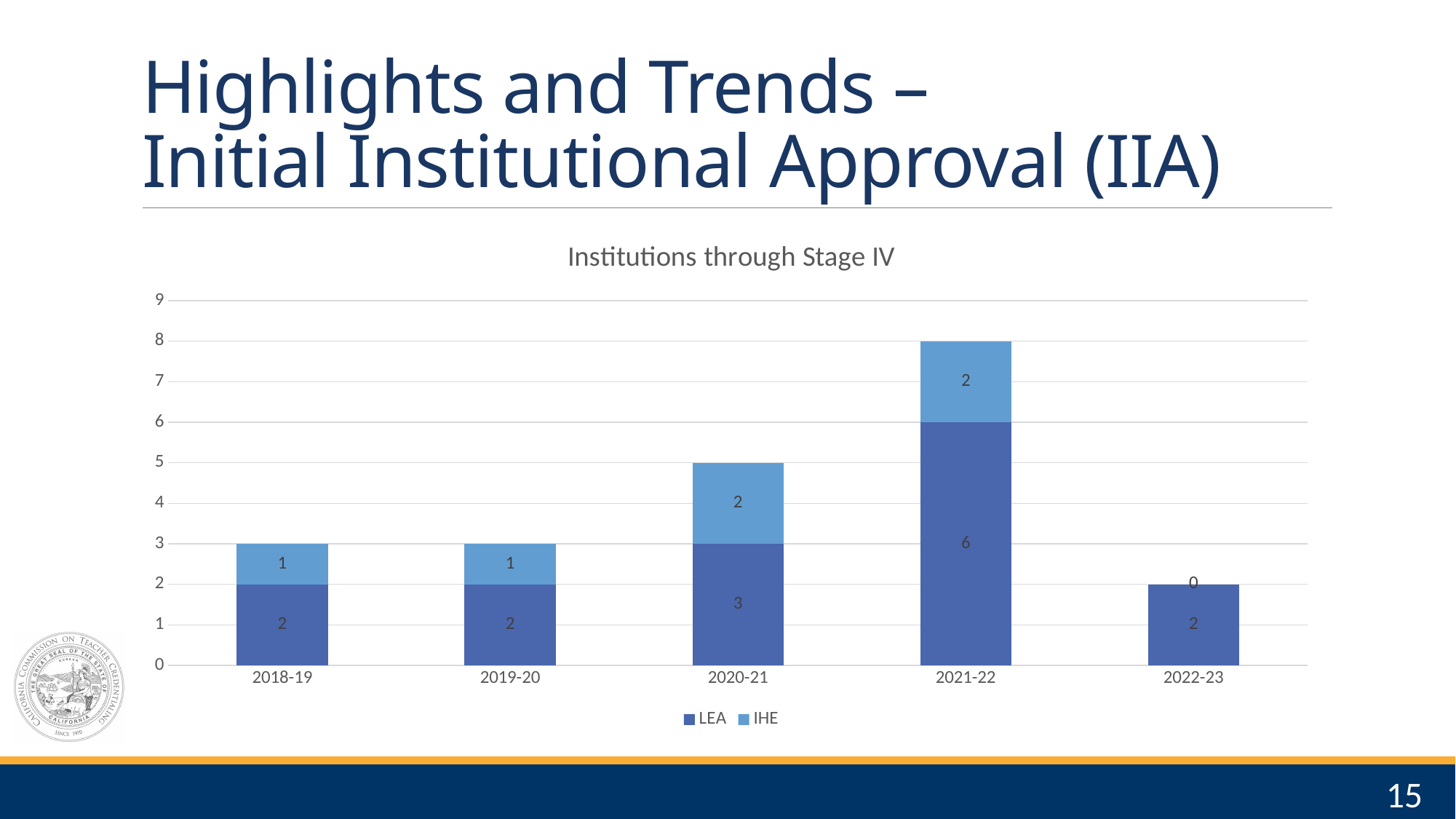
What is the total of the stacked bar for 2020-21? 5 What is the LEA value for 2021-22? 6 How many series does the legend list? 2 How many years are shown on the x axis? 5 Is the LEA value larger for 2020-21 or for 2019-20? 2020-21 Which year has the highest LEA value? 2021-22 Which year has the lowest IHE value? 2022-23 What is the IHE value for 2022-23? 0 What is the title of the chart? Institutions through Stage IV What is the IHE value for 2020-21? 2 What is the total of the stacked bar for 2021-22? 8 What is the difference between the LEA values for 2021-22 and 2020-21? 3